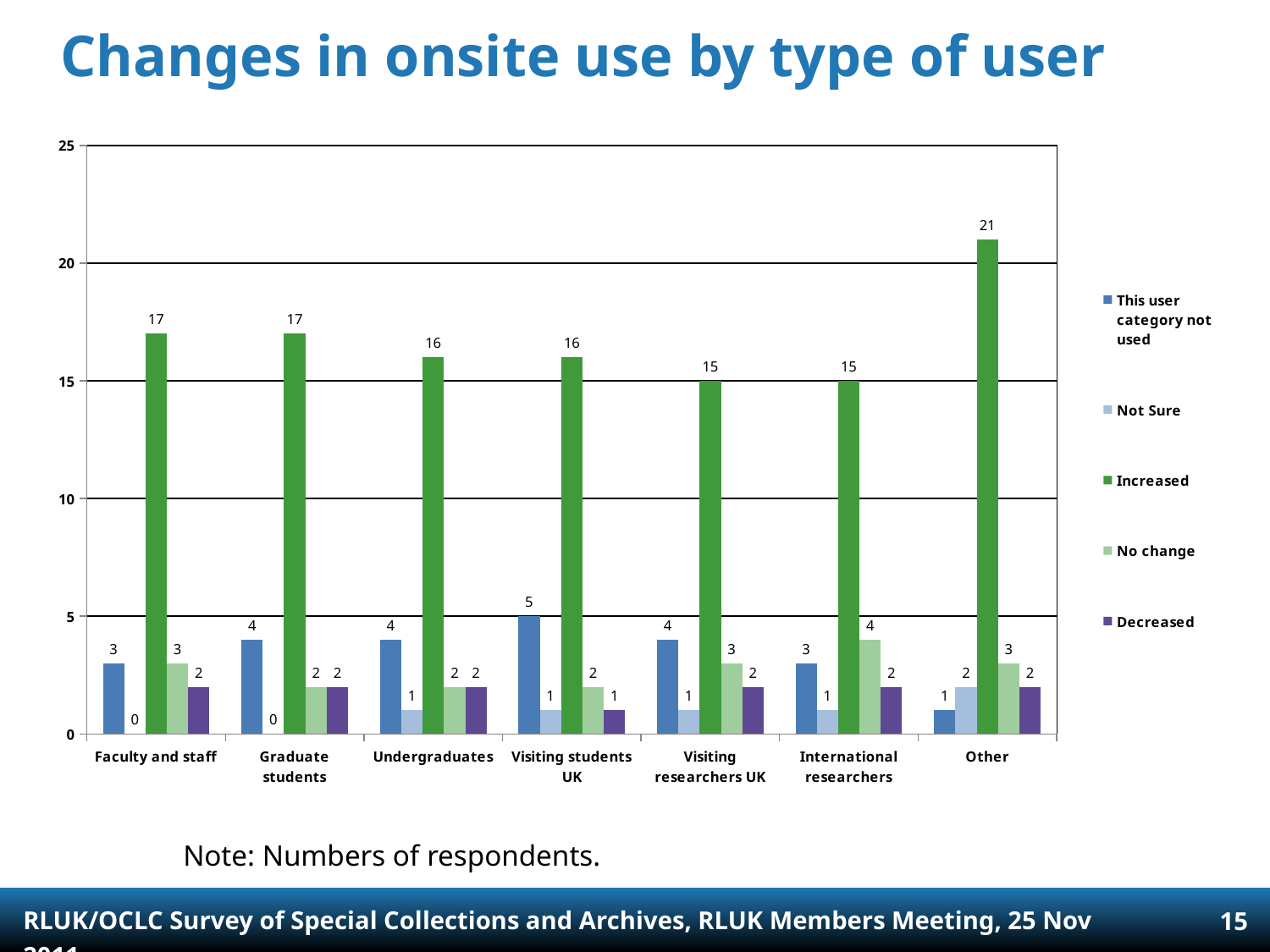
What is the 'Increased' value for Other? 21 What is the 'Not Sure' value for Graduate students? 0 Which is larger: the 'Increased' value for Undergraduates or for Visiting researchers UK? Undergraduates How many user categories are shown on the x axis? 7 How many series does the legend list? 5 What is the 'No change' value for International researchers? 4 Which user category has the lowest 'This user category not used' value? Other Is the 'Increased' value for Other greater or less than 20? greater Which user category has the highest 'Increased' value? Other What type of chart is shown on the slide? Bar chart What is the difference between the 'Increased' values for Other and Faculty and staff? 4 What is the 'This user category not used' value for Visiting students UK? 5